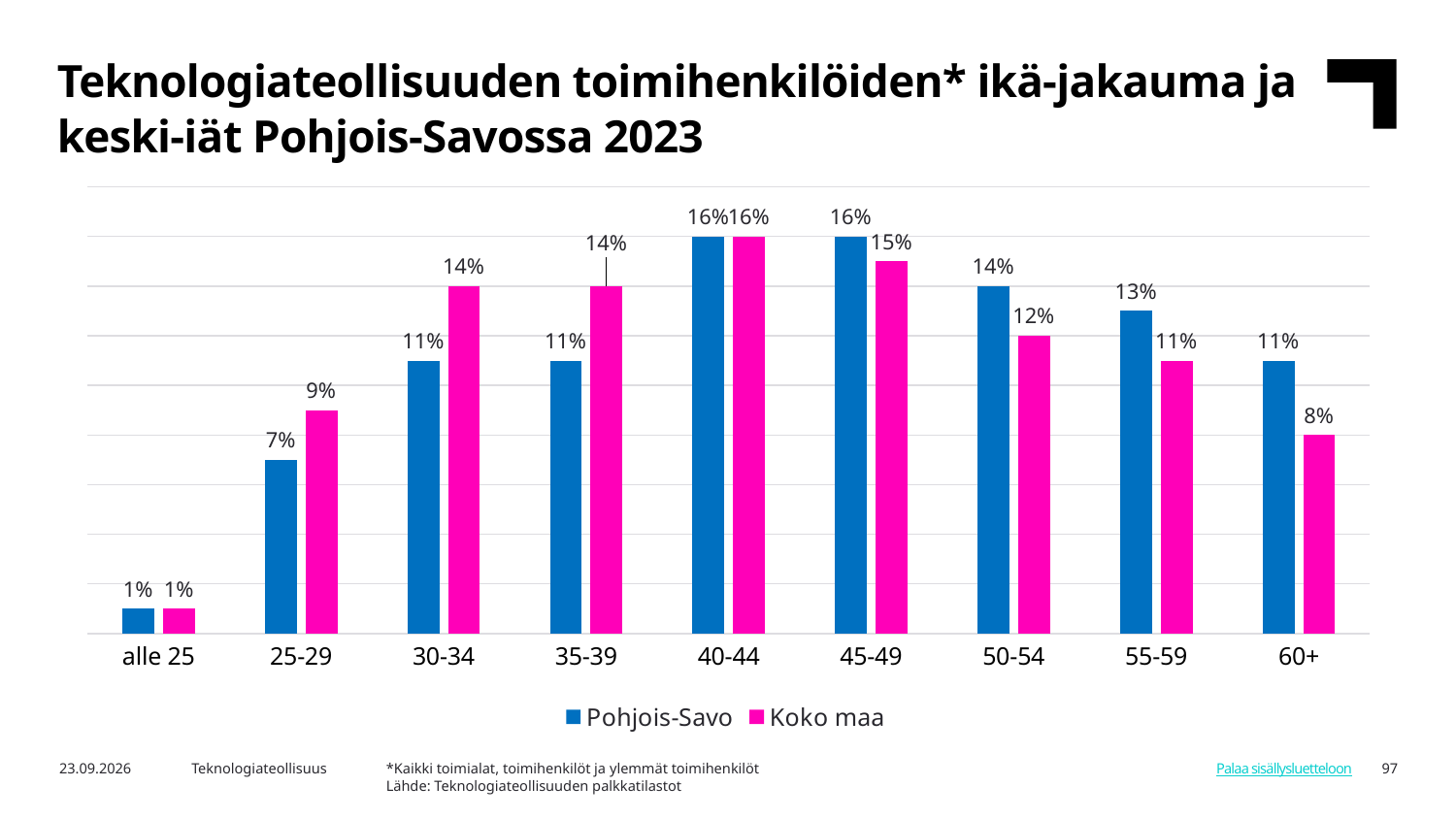
How many age groups are shown on the x axis? 9 What kind of chart is shown on the slide? bar chart Which series is shown in magenta in the legend? Koko maa What is the difference between the Koko maa and Pohjois-Savo values in the 30-34 age group? 3% What is the value for Koko maa in the 60+ age group? 8% Which age group has the lowest value for Pohjois-Savo? alle 25 Which age group has the highest value for Koko maa? 40-44 What is the value for Pohjois-Savo in the 55-59 age group? 13% What is the value for Koko maa in the 30-34 age group? 14% In the 50-54 age group, which series has the larger value, Pohjois-Savo or Koko maa? Pohjois-Savo How many series does the legend list? 2 What is the value for Pohjois-Savo in the 25-29 age group? 7%